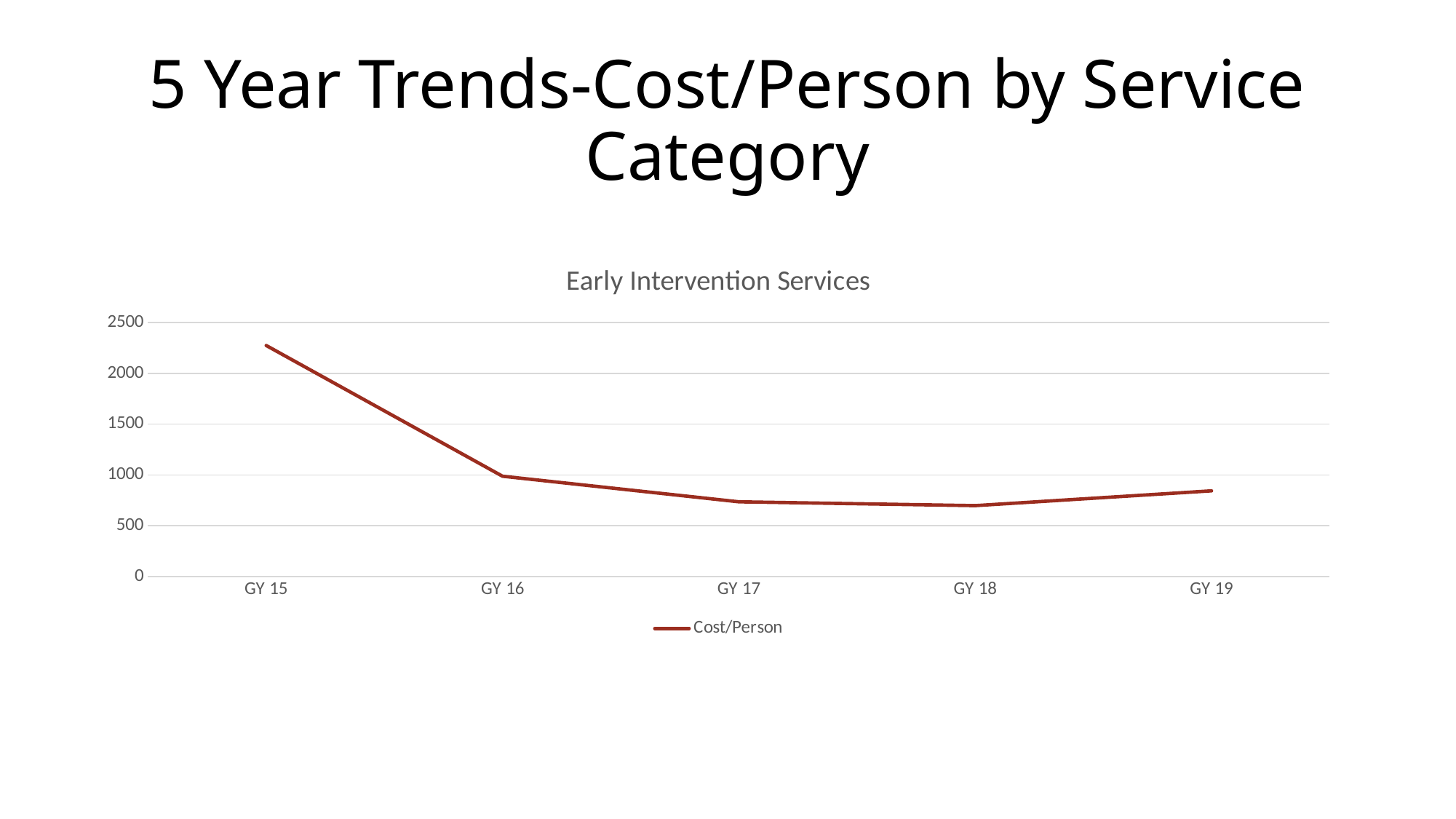
How many series does the legend list? 1 Does the Cost/Person rise or fall from GY 15 to GY 16? fall Is the Cost/Person for GY 17 greater or less than 1000? less How many years are plotted on the x axis? 5 Which is larger, the Cost/Person for GY 15 or for GY 16? GY 15 Which year has the highest Cost/Person? GY 15 Is the Cost/Person for GY 19 greater or less than 1000? less What kind of chart is shown on the slide? line chart Is the Cost/Person for GY 18 greater or less than 500? greater What is the name of the series shown in the legend? Cost/Person What is the title of the chart? Early Intervention Services